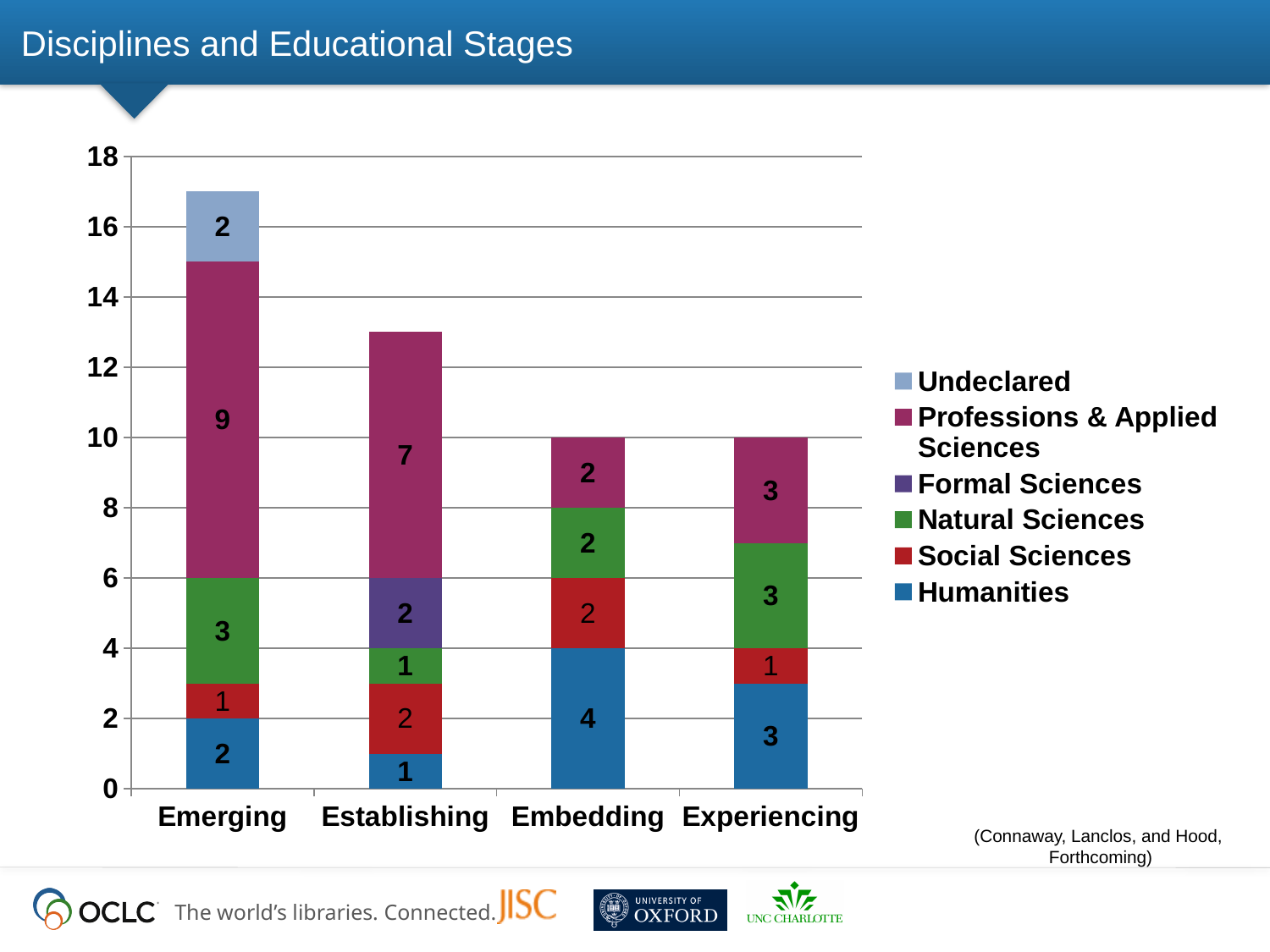
What is the Professions & Applied Sciences value for the Emerging stage? 9 How many educational stages are shown on the x axis? 4 What type of chart is shown on the slide? Stacked bar chart What is the total of the stacked bar for the Establishing stage? 13 What is the total of the stacked bar for the Emerging stage? 17 What is the Formal Sciences value for the Establishing stage? 2 How many series does the legend list? 6 Which is larger: the Humanities value for Embedding or the Humanities value for Experiencing? Embedding What is the difference between the Professions & Applied Sciences values for Emerging and Establishing? 2 What is the Natural Sciences value for the Experiencing stage? 3 Which educational stage has the tallest stacked bar overall? Emerging What is the Humanities value for the Embedding stage? 4